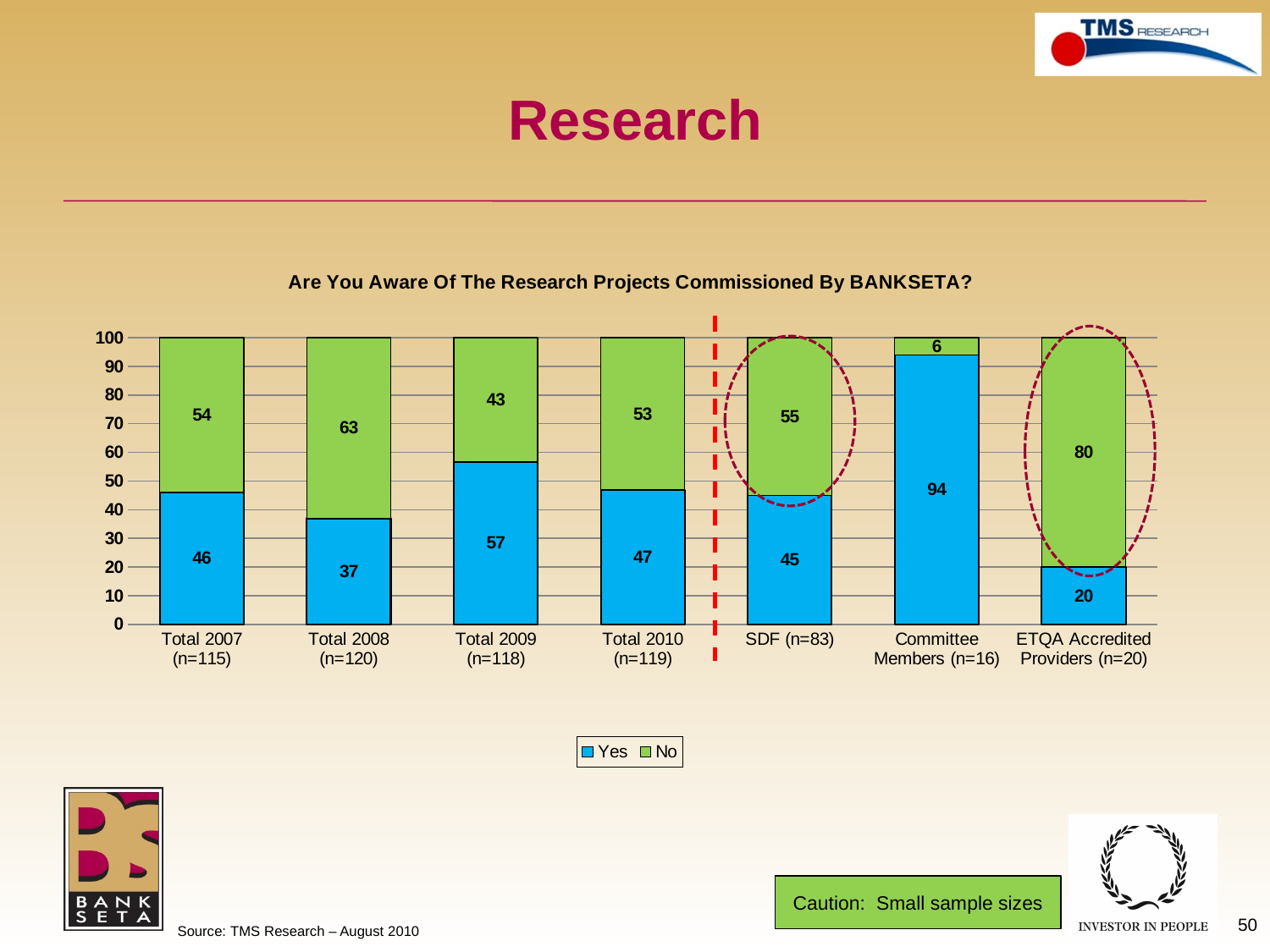
How many series does the legend list? 2 What kind of chart is shown? Stacked bar chart What is the 'Yes' value for Committee Members (n=16)? 94 Which category has the lowest 'Yes' value? ETQA Accredited Providers (n=20) How many categories are shown on the x axis? 7 What is the title of the chart? Are You Aware Of The Research Projects Commissioned By BANKSETA? Which category has the highest 'Yes' value? Committee Members (n=16) What is the 'Yes' value for Total 2009 (n=118)? 57 What is the total of the stacked bar for SDF (n=83)? 100 What is the difference between the 'No' values for Total 2008 (n=120) and Total 2009 (n=118)? 20 Which is larger, the 'Yes' value for Total 2007 (n=115) or the 'Yes' value for Total 2010 (n=119)? Total 2010 (n=119) What is the 'No' value for ETQA Accredited Providers (n=20)? 80